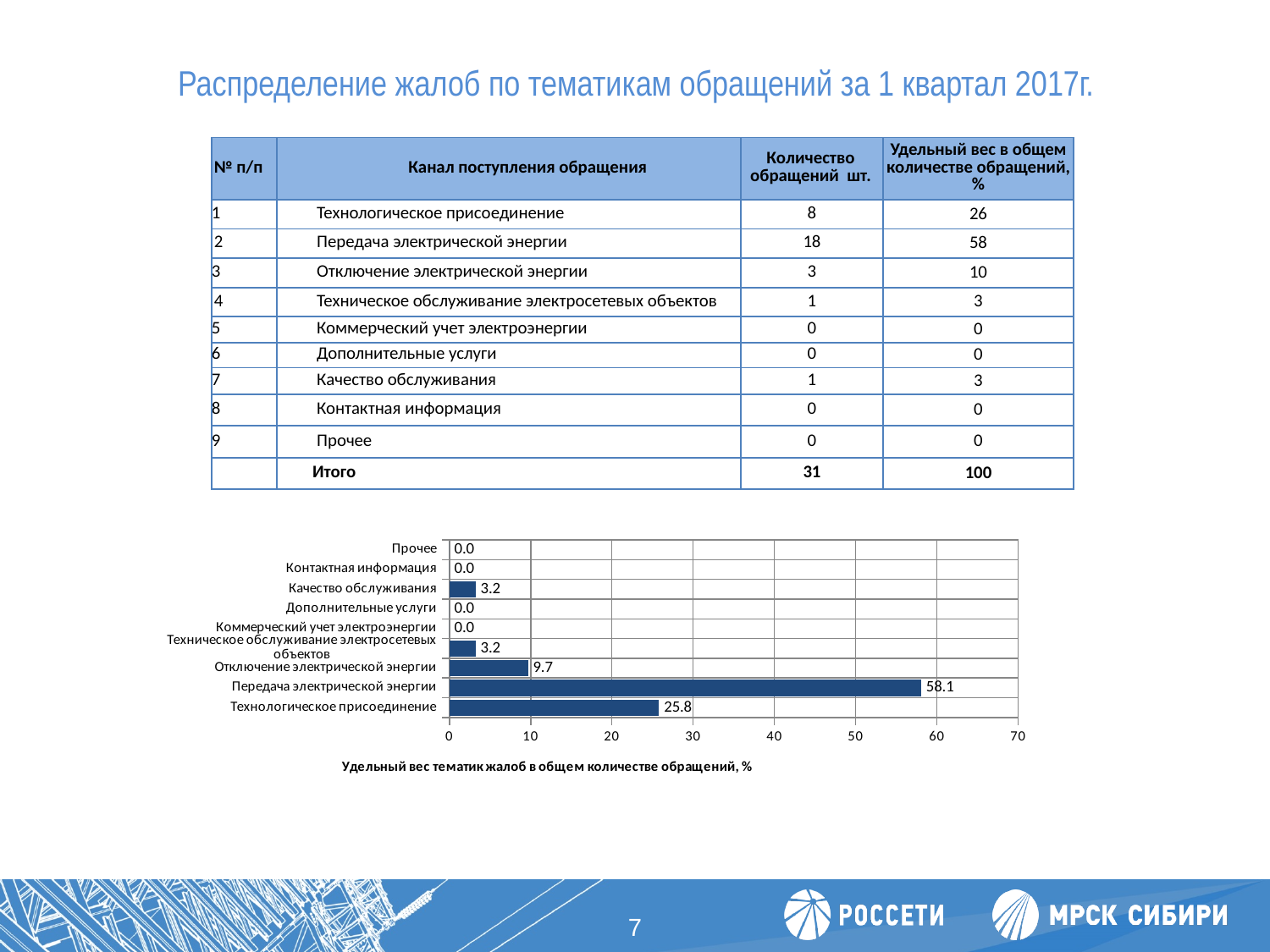
Which category has the highest value in the bar chart? Передача электрической энергии In the bar chart, what is the value for Передача электрической энергии? 58.1 In the bar chart, what is the difference between the values for Передача электрической энергии and Технологическое присоединение? 32.3 In the bar chart, which is larger: the value for Отключение электрической энергии or the value for Технологическое присоединение? Технологическое присоединение In the bar chart, what is the value for Отключение электрической энергии? 9.7 In the bar chart, is the value for Передача электрической энергии greater or less than 50? greater In the bar chart, what is the value for Контактная информация? 0.0 What type of chart is shown on the slide? bar chart What is the title printed below the bar chart? Удельный вес тематик жалоб в общем количестве обращений, % In the bar chart, what is the value for Технологическое присоединение? 25.8 How many categories are shown in the bar chart? 9 In the bar chart, what is the value for Качество обслуживания? 3.2